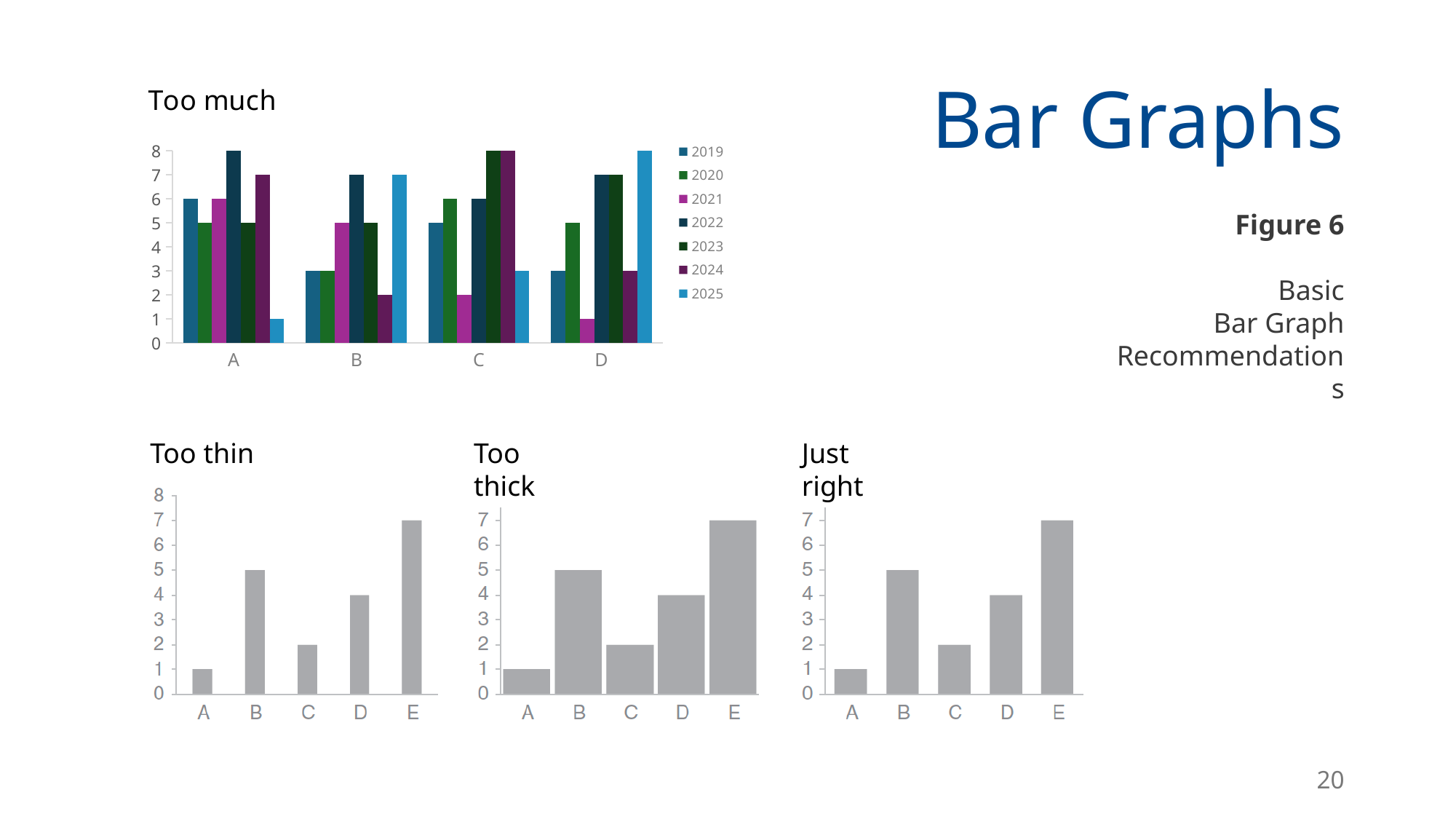
How many series does the legend of the "Too much" chart list? 7 In the "Just right" chart, what is the value for E? 7 In the "Just right" chart, what is the difference between the values for B and C? 3 How many categories are shown on the x axis of the "Too thick" chart? 5 In the "Too much" chart, which series has the highest value in category D? 2025 In the "Too thin" chart, which is larger, the value for B or the value for D? B In the "Too thin" chart, which category has the lowest value? A In the "Too thick" chart, which category has the highest value? E In the "Too much" chart, what is the value for 2025 in category A? 1 How many categories are shown on the x axis of the "Too much" chart? 4 What kind of chart is the "Too much" chart? Bar chart In the "Too much" chart, is the value for 2022 in category A greater or less than 7? greater